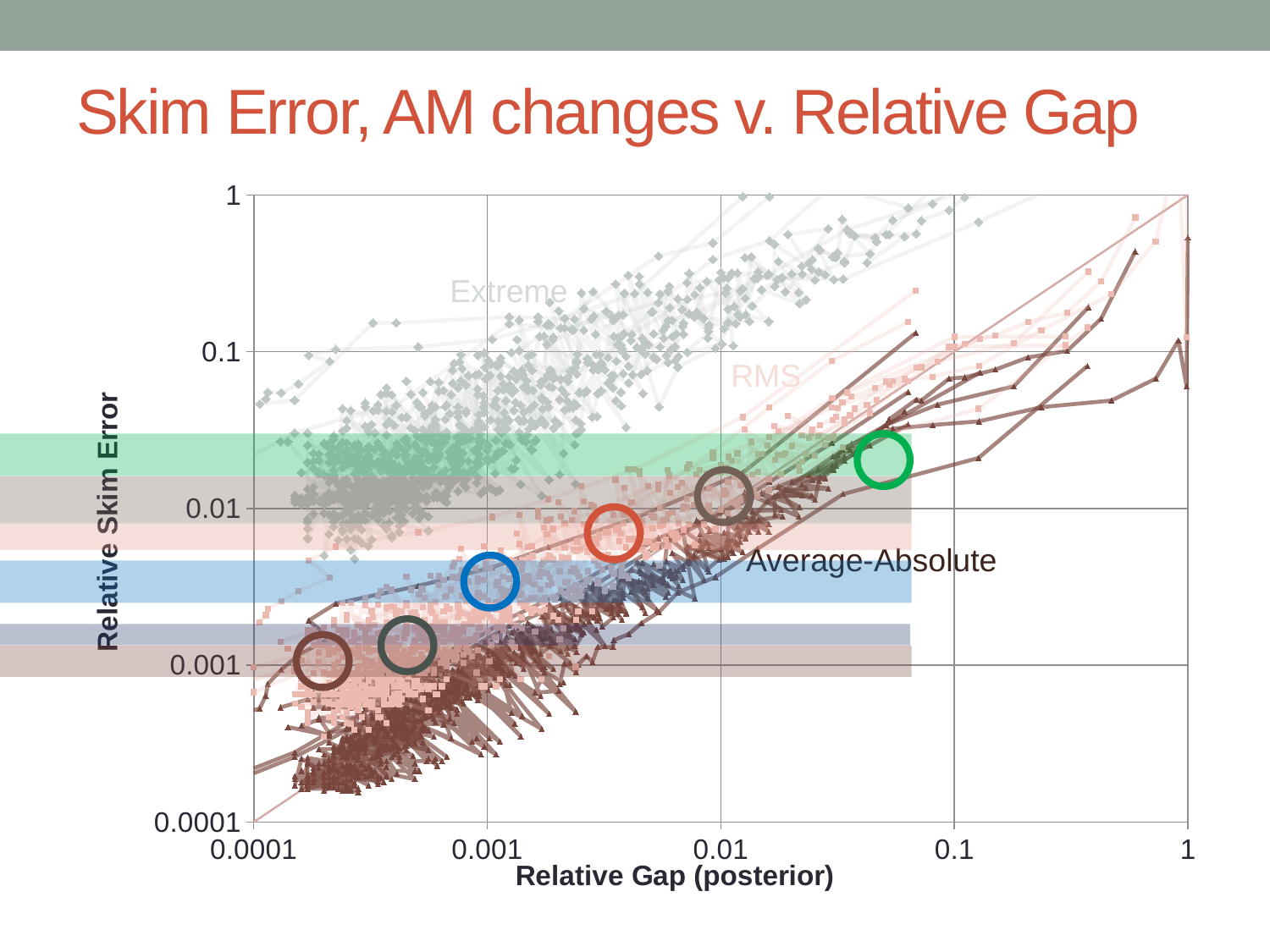
Does the relative skim error rise or fall as the relative gap increases along the x axis? rise How many named series are labelled on the chart? 3 What kind of chart is shown on the slide? scatter chart Which series is plotted highest on the chart, Extreme or Average-Absolute? Extreme What is the label of the x axis? Relative Gap (posterior) Which labelled series has the highest relative skim error values overall? Extreme Which labelled series has the lowest relative skim error values overall? Average-Absolute What is the lowest value shown on the y axis? 0.0001 What is the title of the chart? Skim Error, AM changes v. Relative Gap Which series lies between Extreme and Average-Absolute on the chart? RMS Is the Average-Absolute series at a relative gap of 0.001 greater or less than 0.01 relative skim error? less